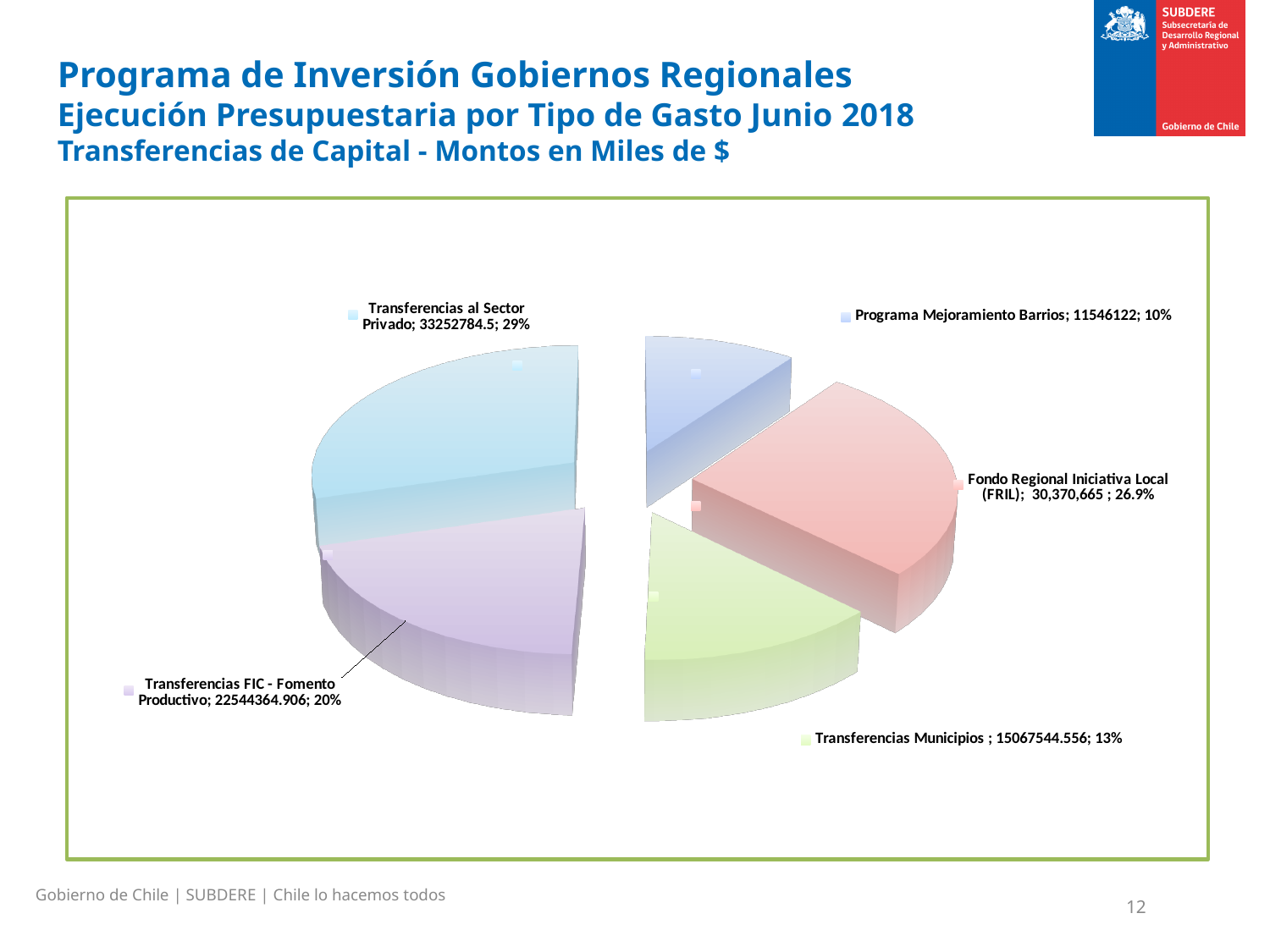
What value is shown for Transferencias al Sector Privado? 33252784.5 What value is shown for Transferencias Municipios? 15067544.556 Which is larger, Transferencias Municipios or Transferencias FIC - Fomento Productivo? Transferencias FIC - Fomento Productivo What kind of chart is shown on the slide? Pie chart What value is shown for Fondo Regional Iniciativa Local (FRIL)? 30,370,665 Which category has the largest slice of the pie? Transferencias al Sector Privado What percentage share of the pie does Fondo Regional Iniciativa Local (FRIL) have? 26.9% Which category has the smallest slice of the pie? Programa Mejoramiento Barrios How many slices does the pie chart have? 5 What value is shown for Programa Mejoramiento Barrios? 11546122 What is the difference in percentage share between Transferencias al Sector Privado and Programa Mejoramiento Barrios? 19 percentage points What percentage share of the pie does Transferencias FIC - Fomento Productivo have? 20%